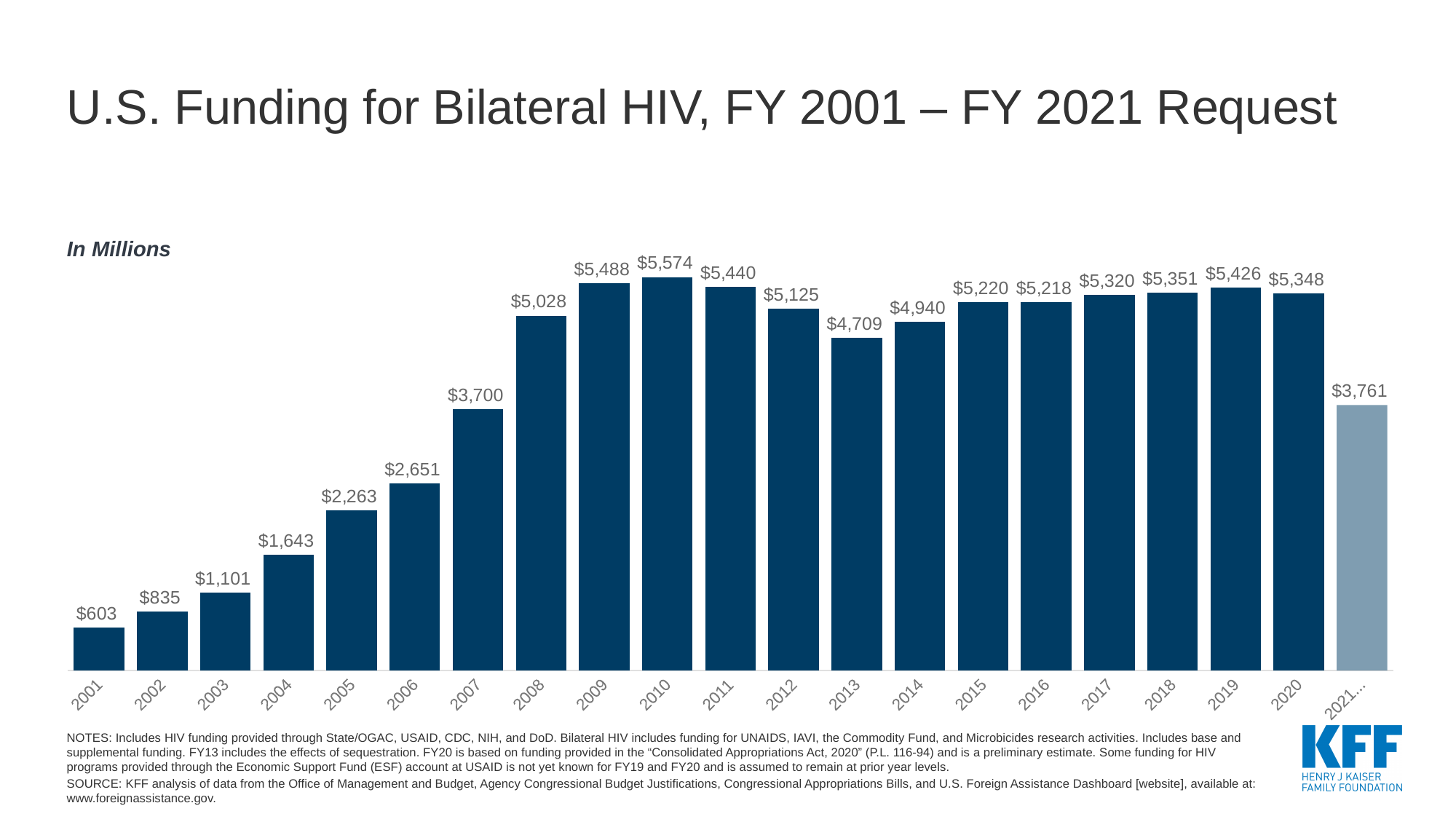
What is the title of the chart? U.S. Funding for Bilateral HIV, FY 2001 – FY 2021 Request What is the difference between the values for 2010 and 2013? $865 Which is larger, the value for 2019 or the value for 2020? 2019 What is the value for 2010? $5,574 Do the values rise or fall from 2001 to 2010? Rise What kind of chart is shown on the slide? Bar chart Which year has the lowest value? 2001 What is the value for the 2021 request bar? $3,761 What is the value for 2001? $603 Which year has the highest value? 2010 In what unit are the values expressed, according to the label above the chart? In Millions How many bars are shown in the chart? 21